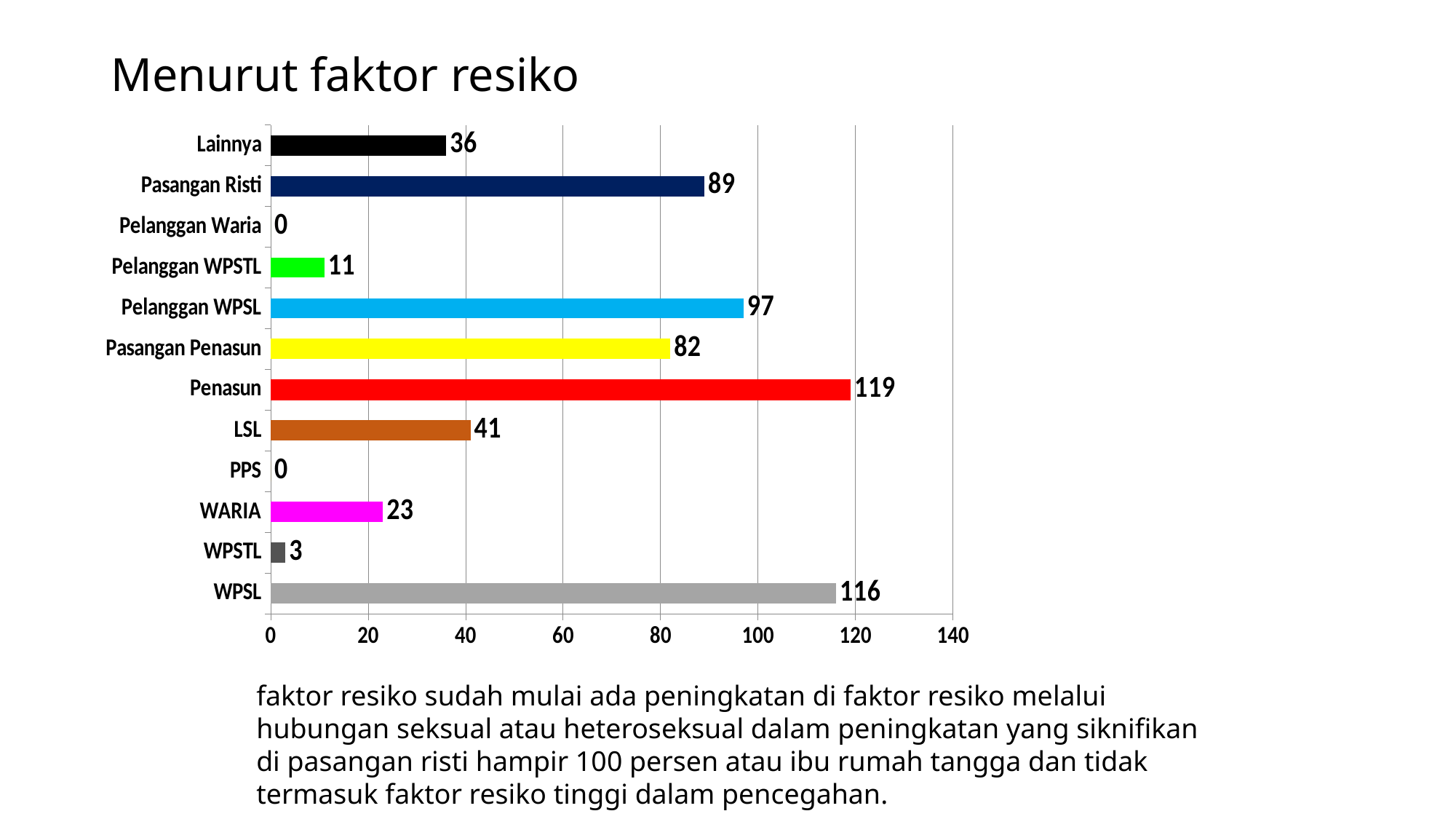
What is the value for Penasun? 119 What is the value for WARIA? 23 Is the value for Pasangan Risti greater or less than 100? less What is the difference between the values for Pelanggan WPSL and Pasangan Penasun? 15 What is the value for Pasangan Risti? 89 How many categories are shown on the chart? 12 Which categories have a value of 0? Pelanggan Waria and PPS Which is larger, the value for LSL or the value for Lainnya? LSL What kind of chart is shown on the slide? bar chart What is the difference between the values for WPSL and WPSTL? 113 What is the title of the slide? Menurut faktor resiko Which category has the highest value? Penasun